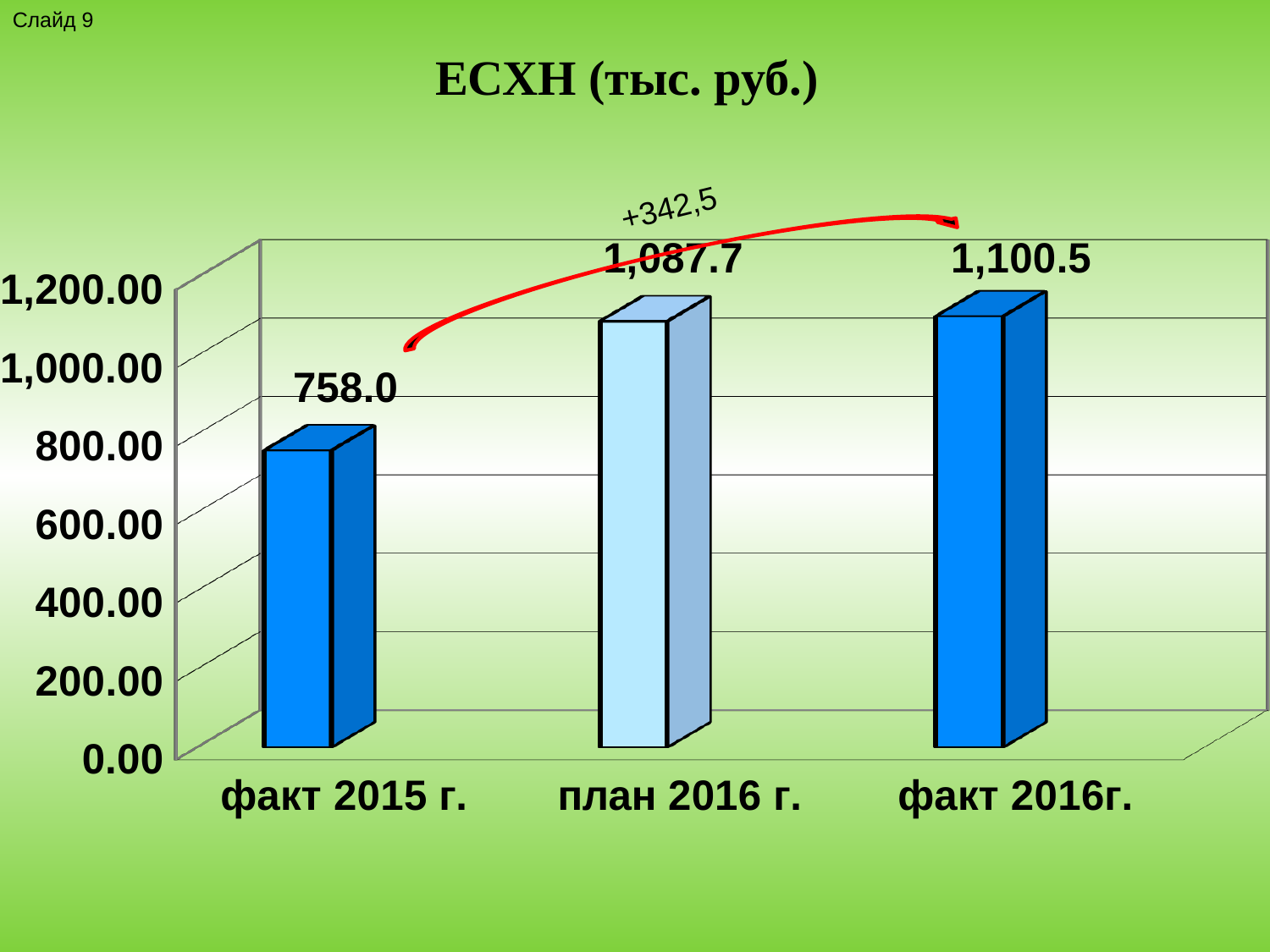
What is the difference between the values for факт 2016г. and факт 2015 г.? 342.5 What is the title of the chart? ЕСХН (тыс. руб.) What is the value for факт 2015 г.? 758.0 What is the difference between the values for план 2016 г. and факт 2015 г.? 329.7 Which category has the highest value? факт 2016г. How many categories are shown on the chart? 3 What is the difference between the values for факт 2016г. and план 2016 г.? 12.8 Is the value for факт 2015 г. greater or less than 800.00? less What is the value for план 2016 г.? 1,087.7 Which category has the lowest value? факт 2015 г. Which is larger, the value for план 2016 г. or the value for факт 2015 г.? план 2016 г. What is the value for факт 2016г.? 1,100.5